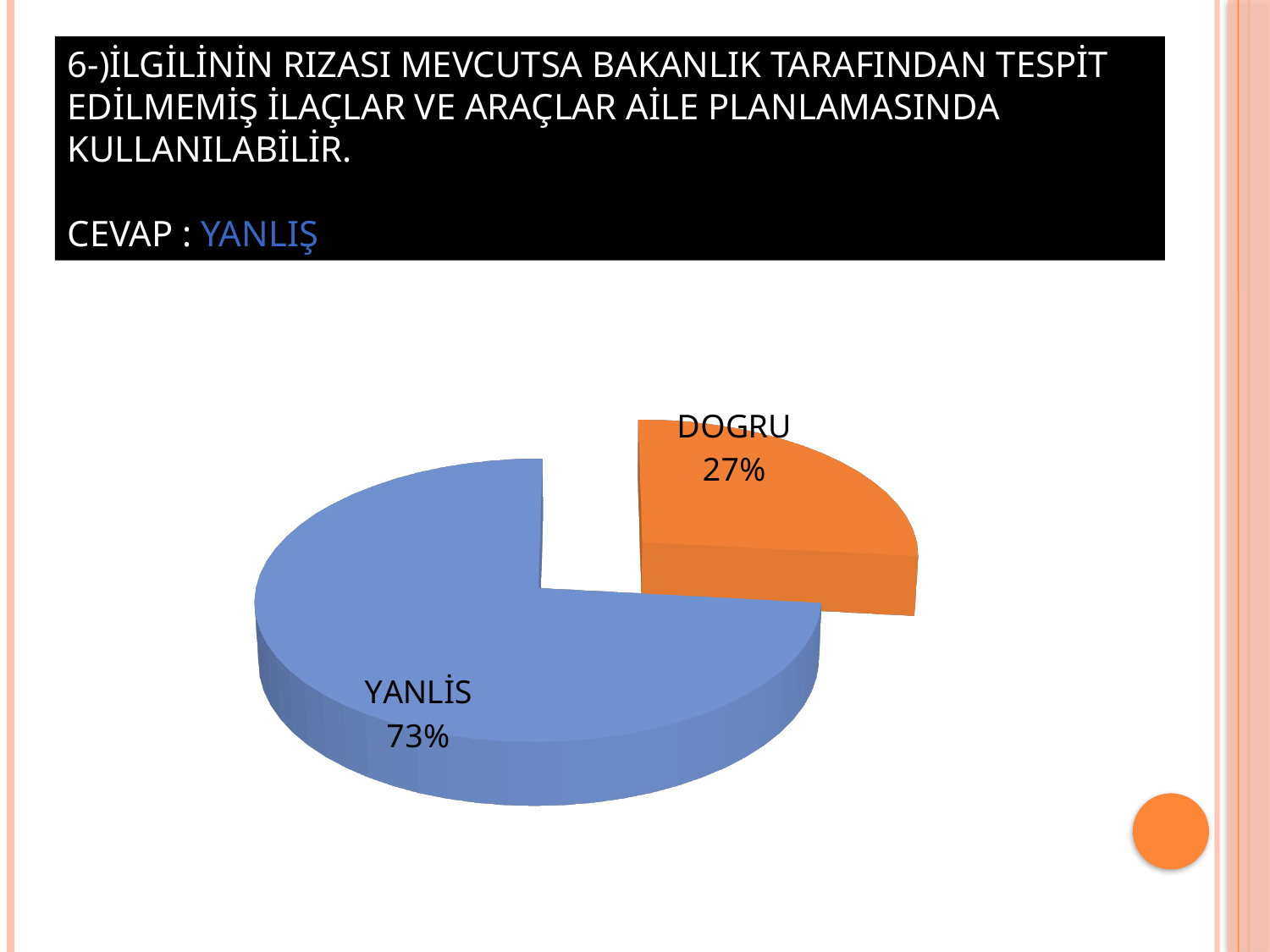
Which slice of the pie chart is the largest? YANLİS What percentage of the pie chart is labelled YANLİS? 73% Which slice of the pie chart is the smallest? DOGRU What kind of chart is shown on the slide? Pie chart What is the difference in percentage points between the YANLİS and DOGRU slices? 46 Which slice is larger, DOGRU or YANLİS? YANLİS How many slices does the pie chart have? 2 What share of the pie does the DOGRU slice represent? 27% What colour is the YANLİS slice of the pie chart? Blue What percentage of the pie chart is labelled DOGRU? 27% What colour is the DOGRU slice of the pie chart? Orange